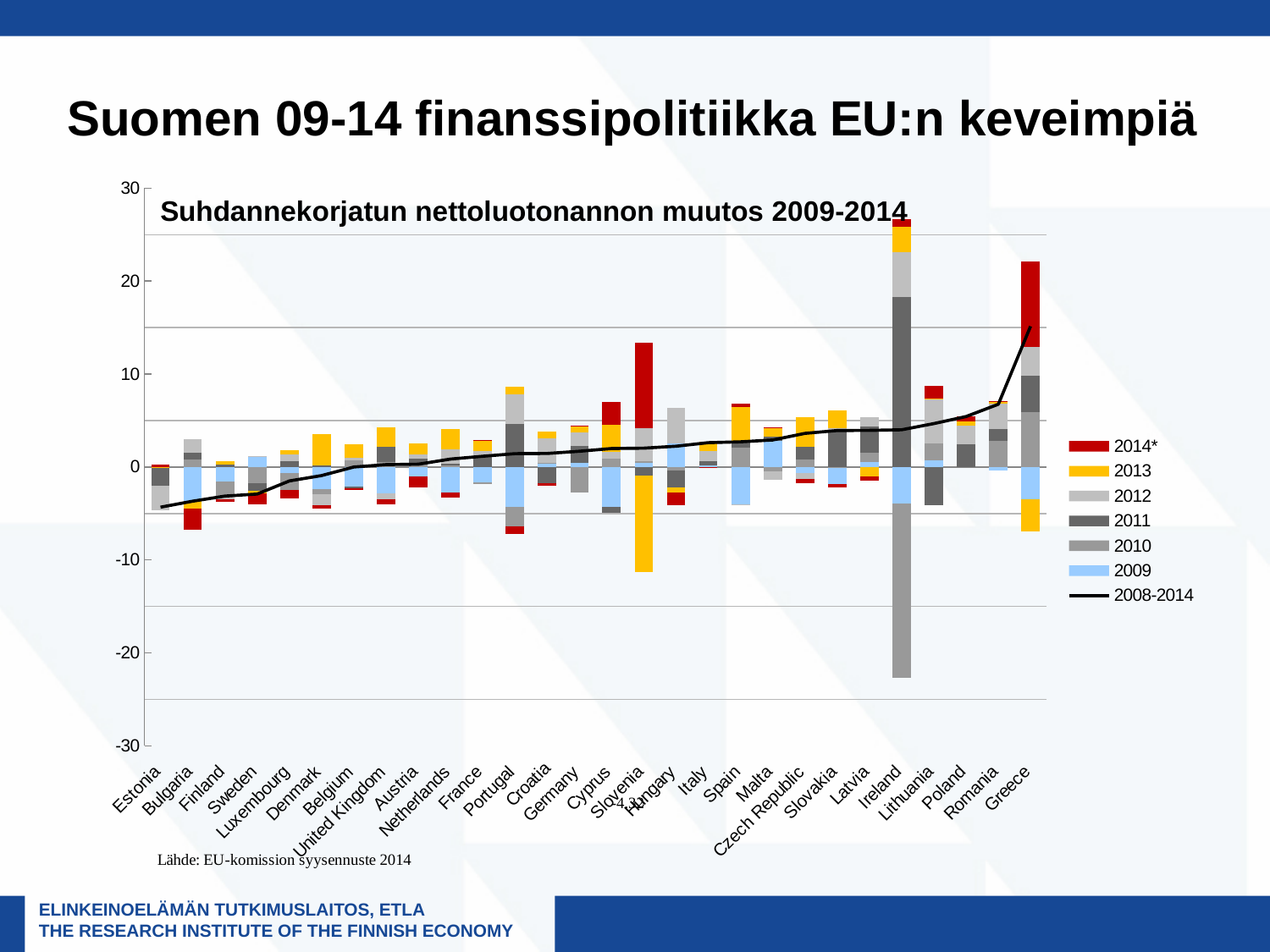
Which country has the lowest value on the 2008-2014 line? Estonia Is the top of the stacked bar for Greece greater or less than 20? greater What is the title of the chart? Suhdannekorjatun nettoluotonannon muutos 2009-2014 Is the bottom of the 2010 bar segment for Ireland greater or less than -20? less How many series does the legend list? 7 Is the 2008-2014 line value for Greece greater or less than 10? greater What kind of chart is shown on the slide? Stacked bar chart with a line Which country has the highest value on the 2008-2014 line? Greece Does the 2008-2014 line rise or fall from Estonia on the left to Greece on the right? Rises How many countries are shown on the x axis? 28 Which legend entry is drawn as a line rather than bars? 2008-2014